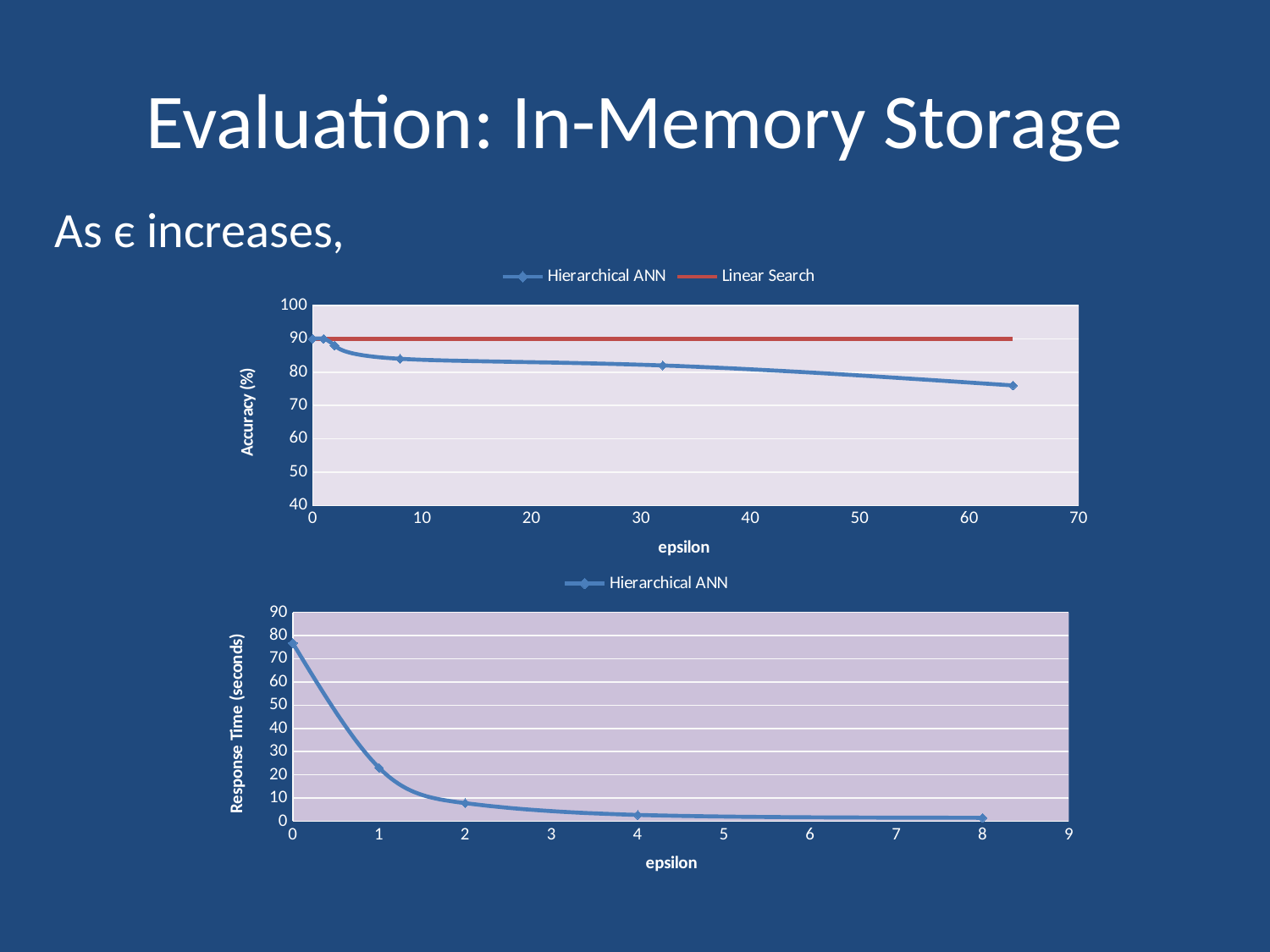
How many series does the legend of the bottom chart list? 1 In the top chart, does the accuracy of Hierarchical ANN rise or fall as epsilon increases? fall How many data points are plotted in the bottom chart? 5 What kind of chart is the top chart on the slide? line chart In the top chart, what are the two series named in the legend? Hierarchical ANN and Linear Search In the top chart, at epsilon 64, which series has the higher accuracy, Hierarchical ANN or Linear Search? Linear Search How many series does the legend of the top chart list? 2 What is the y-axis title of the bottom chart? Response Time (seconds) In the bottom chart, is the response time at epsilon 0 greater or less than 70? greater In the top chart, is the Linear Search accuracy greater or less than 80? greater In the top chart, is the Hierarchical ANN accuracy at epsilon 64 greater or less than 80? less In the bottom chart, does the response time rise or fall as epsilon increases? fall